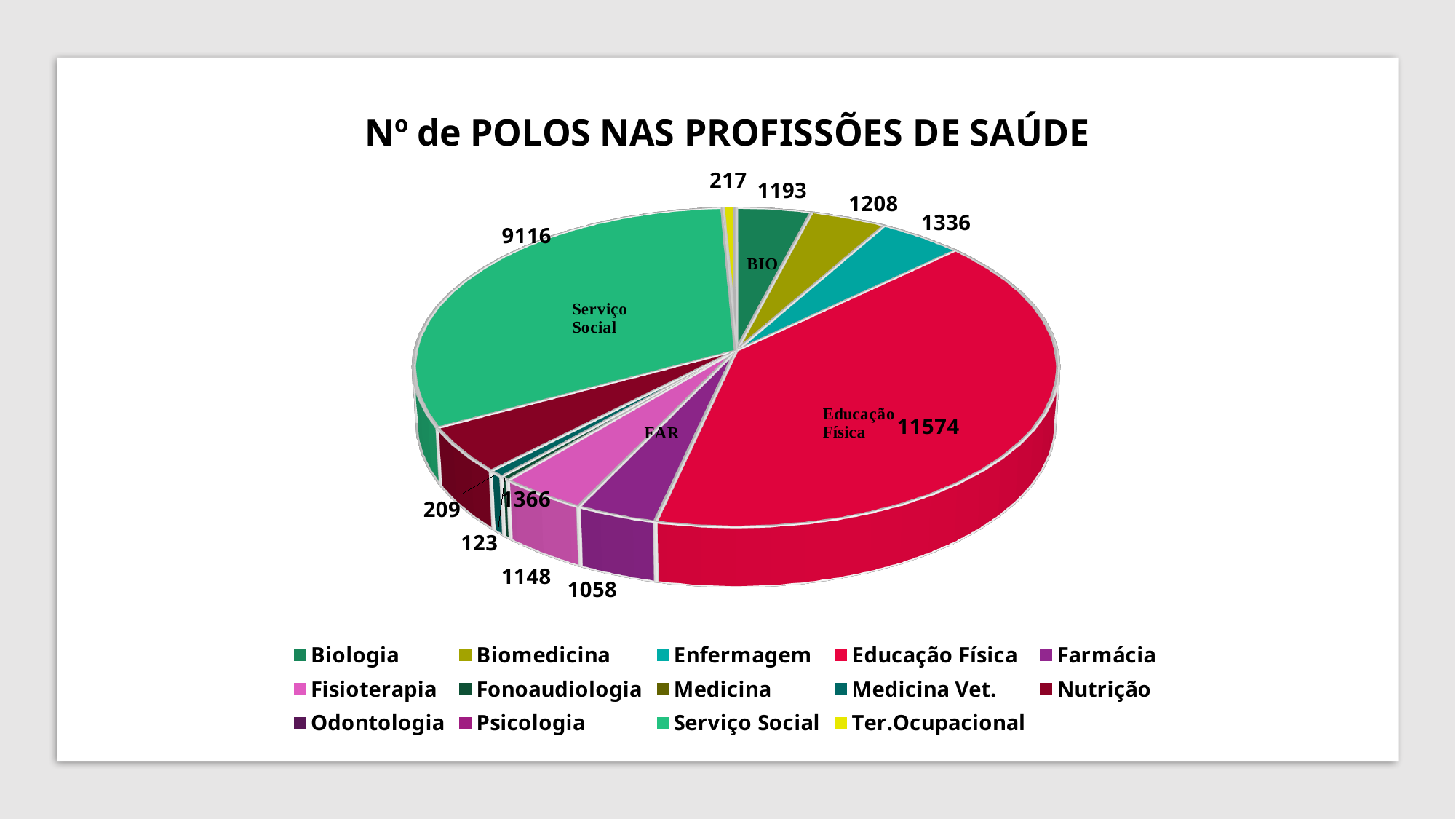
What kind of chart is shown on the slide? pie chart Which is larger, the value for Biomedicina or the value for Enfermagem? Enfermagem What is the difference between the values for Educação Física and Serviço Social? 2458 What is the value for Enfermagem? 1336 What is the value for Ter.Ocupacional? 217 What is the title of the chart? Nº de POLOS NAS PROFISSÕES DE SAÚDE How many categories does the legend list? 14 What is the value for Educação Física? 11574 What colour is the Educação Física slice? red What is the value for Serviço Social? 9116 Which category has the largest slice? Educação Física What is the value for Biologia? 1193